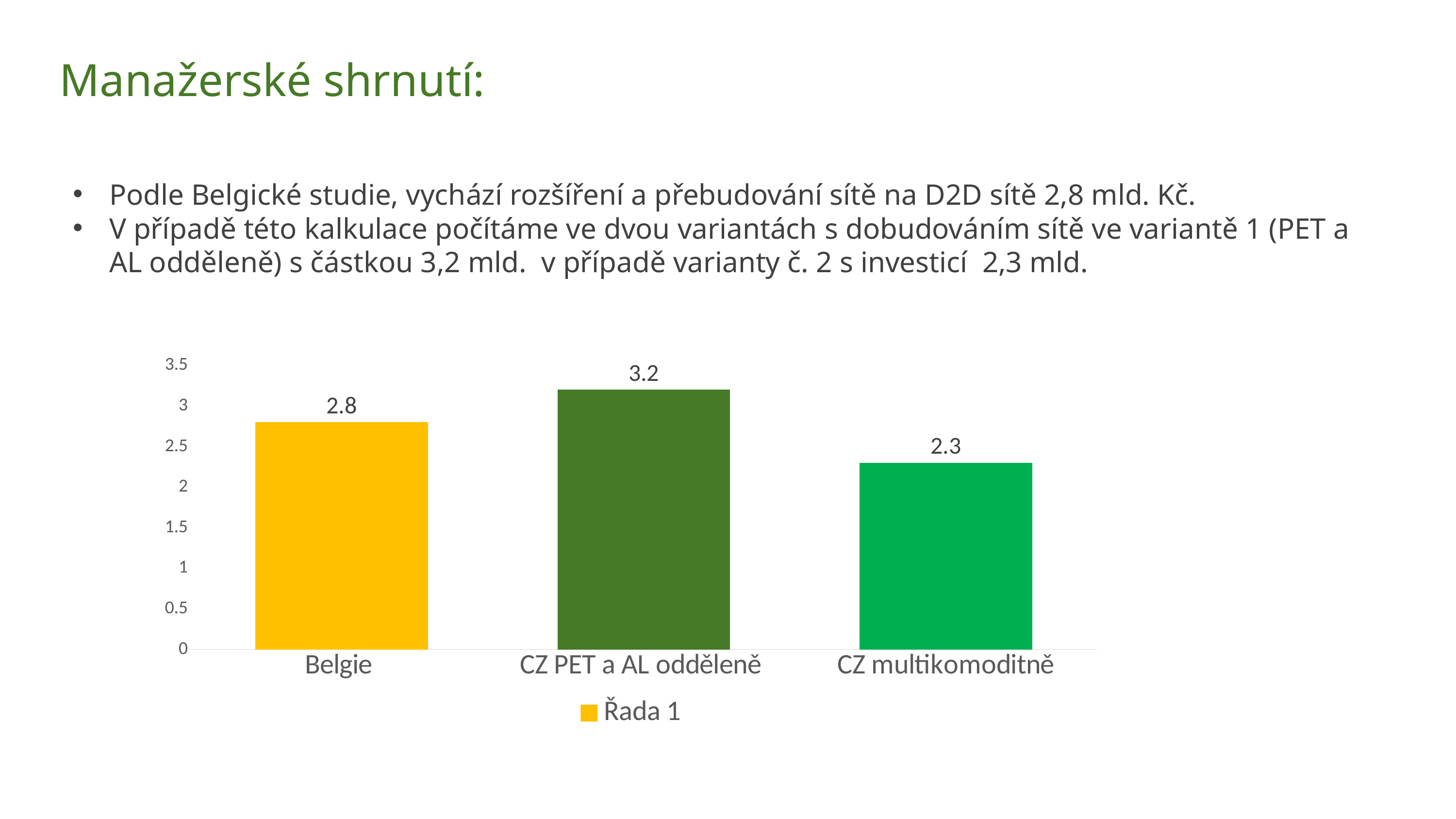
What kind of chart is shown on the slide? bar chart What is the value for CZ multikomoditně? 2.3 What is the value for Belgie? 2.8 Which category has the highest value? CZ PET a AL odděleně What is the value for CZ PET a AL odděleně? 3.2 What series name does the legend show? Řada 1 Which category has the lowest value? CZ multikomoditně What is the difference between the values for CZ PET a AL odděleně and CZ multikomoditně? 0.9 Which is larger, the value for Belgie or the value for CZ multikomoditně? Belgie How many categories are shown on the x axis? 3 What is the difference between the values for CZ PET a AL odděleně and Belgie? 0.4 Is the value for CZ PET a AL odděleně greater or less than 3? greater